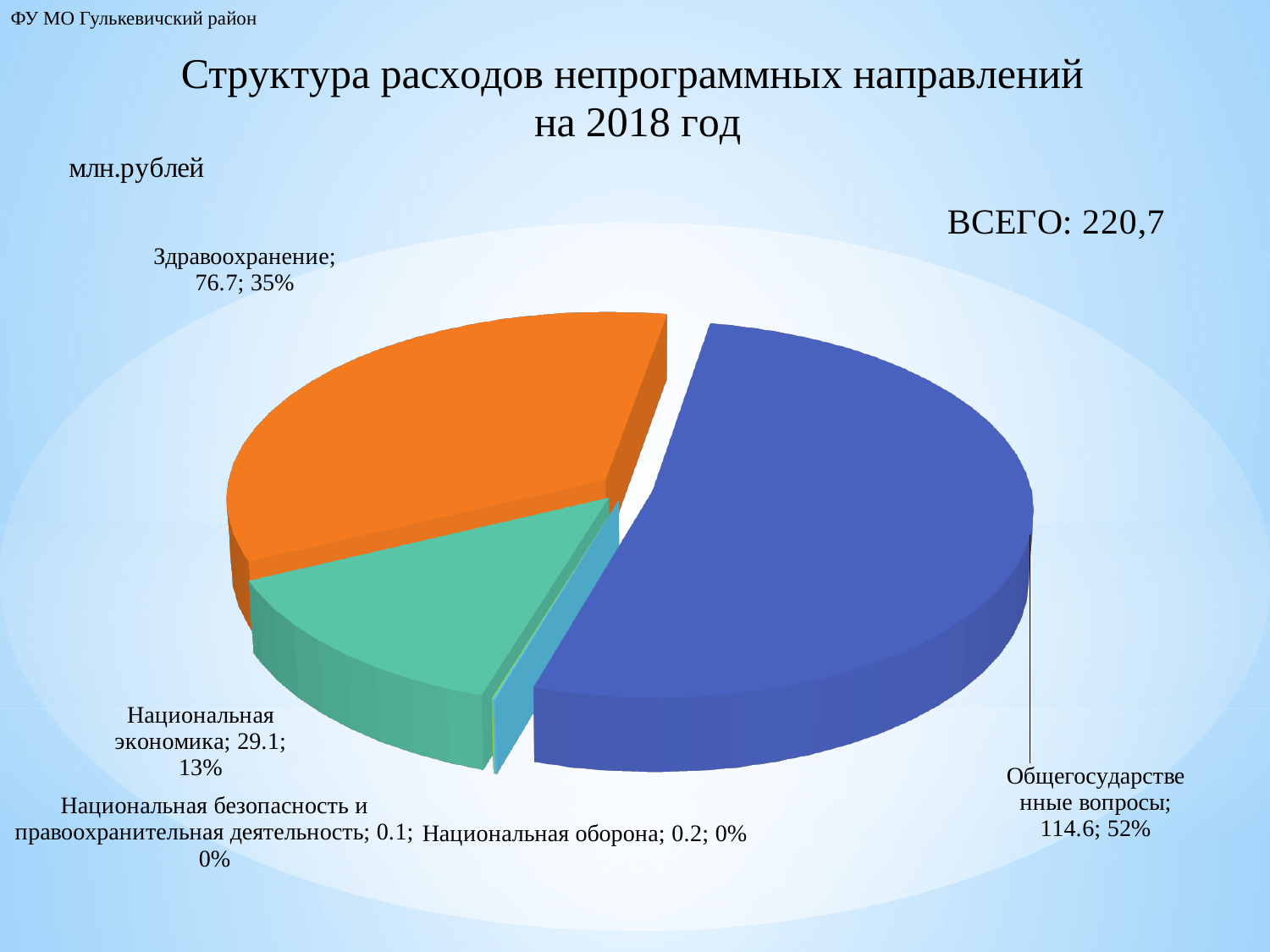
What is the difference between the values for Общегосударственные вопросы and Здравоохранение? 37.9 What is the value for Национальная оборона? 0.2 What kind of chart is shown on the slide? pie chart Which category has the largest value? Общегосударственные вопросы What is the value for Общегосударственные вопросы? 114.6 Which category has the smallest value? Национальная безопасность и правоохранительная деятельность What total (ВСЕГО) is stated on the slide? 220,7 What is the value for Здравоохранение? 76.7 How many categories does the pie chart show? 5 What is the value for Национальная экономика? 29.1 What share of the pie does Общегосударственные вопросы take? 52% What share of the pie does Здравоохранение take? 35%